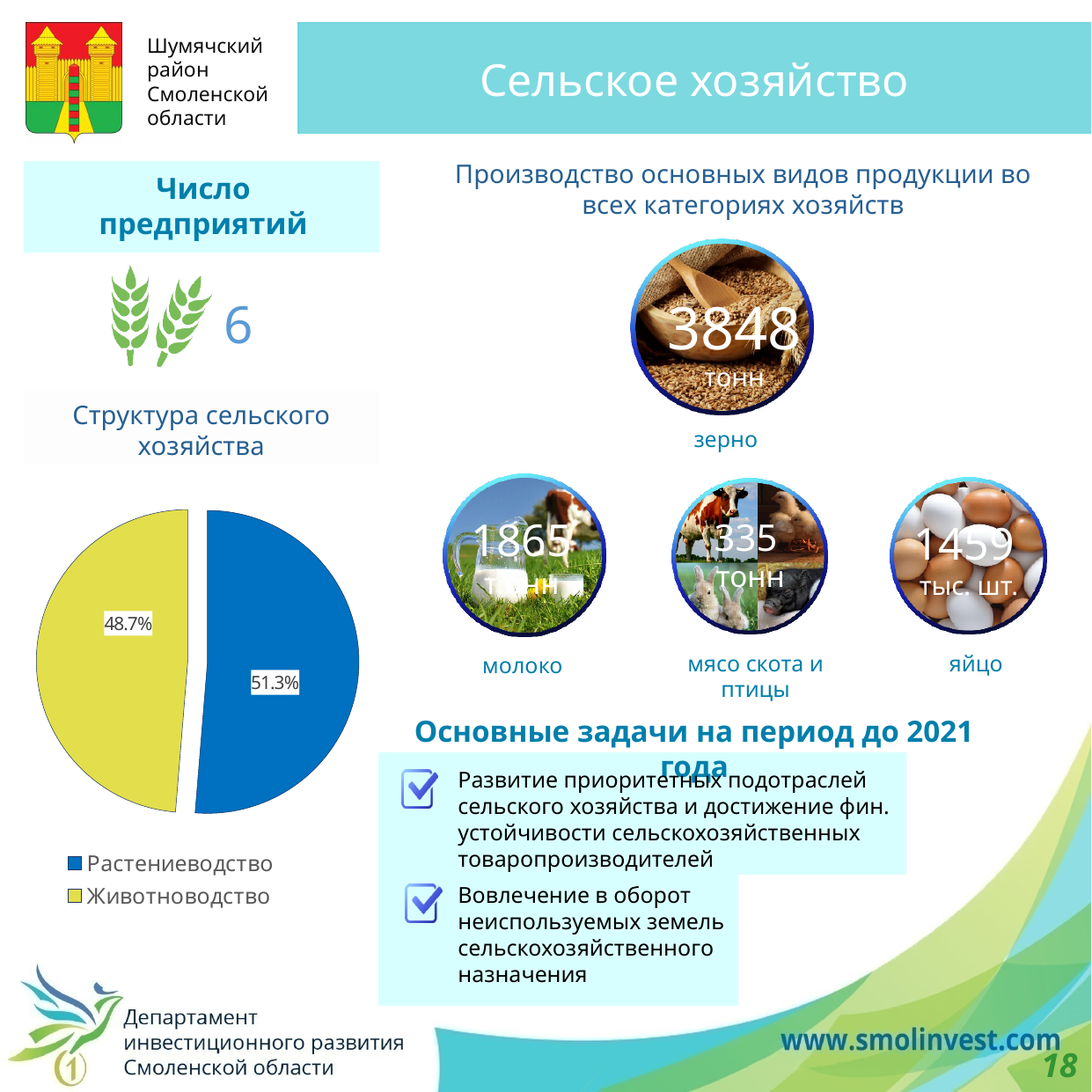
What colour is the Растениеводство slice in the pie chart? Blue What is the title shown above the pie chart? Структура сельского хозяйства Which slice of the pie chart is the largest? Растениеводство Which is larger in the pie chart, Растениеводство or Животноводство? Растениеводство What is the combined share of the two slices in the pie chart? 100% What kind of chart is shown on the slide? Pie chart How many slices does the pie chart have? 2 What share of the pie chart does Растениеводство account for? 51.3% By how many percentage points does the Растениеводство slice exceed the Животноводство slice? 2.6 percentage points How many entries does the pie chart's legend list? 2 Which slice of the pie chart is the smallest? Животноводство What share of the pie chart does Животноводство account for? 48.7%